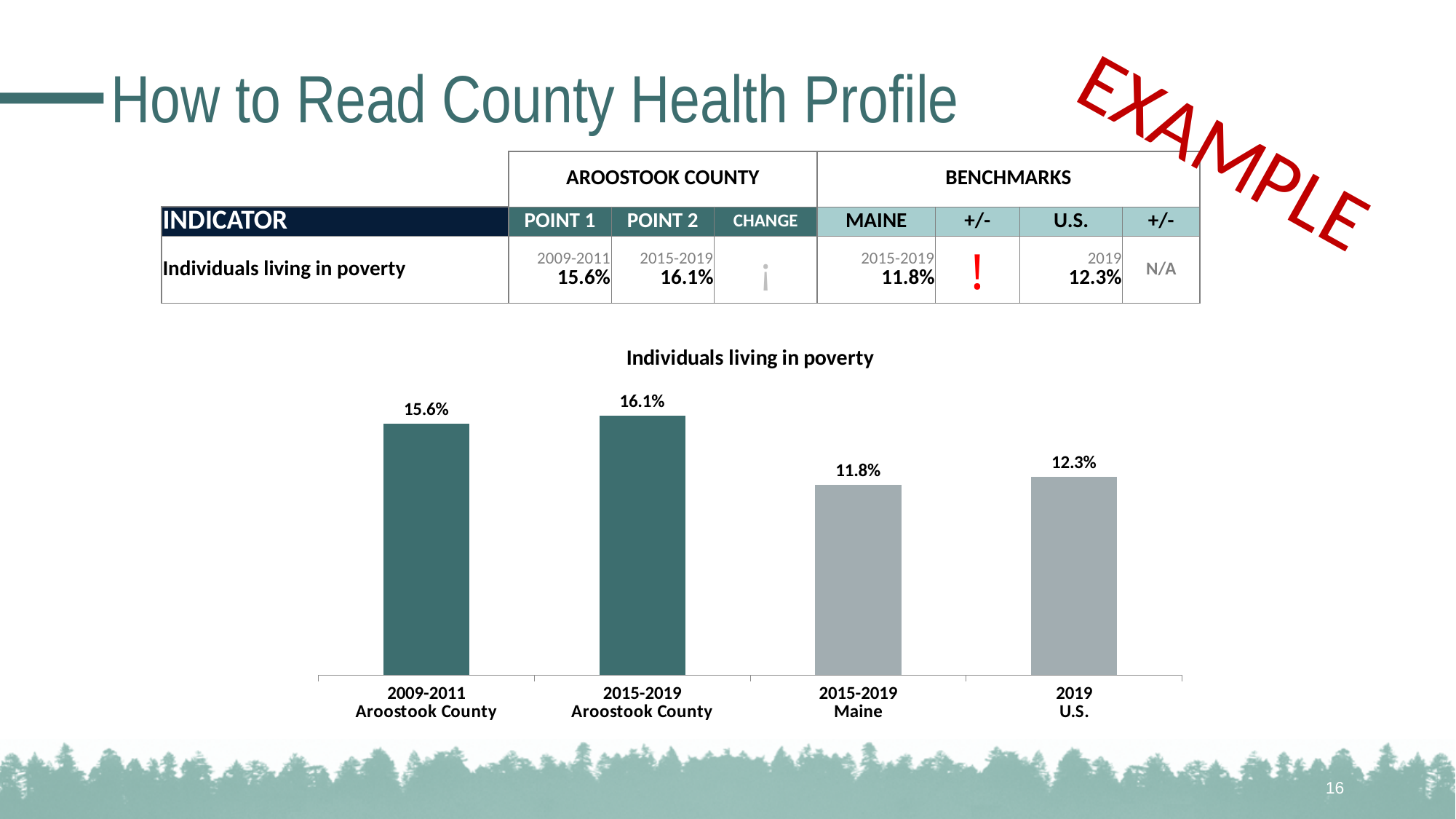
What is the value for 2015-2019 Aroostook County in the chart? 16.1% Which category has the highest value in the chart? 2015-2019 Aroostook County Which category has the lowest value in the chart? 2015-2019 Maine What is the difference between the 2015-2019 Aroostook County value and the 2015-2019 Maine value? 4.3% What is the value for 2019 U.S. in the chart? 12.3% What is the value for 2009-2011 Aroostook County in the chart? 15.6% What is the value for 2015-2019 Maine in the chart? 11.8% What type of chart is shown on the slide? Bar chart How many bars are shown in the chart? 4 What is the title of the chart? Individuals living in poverty What is the difference between the 2019 U.S. value and the 2015-2019 Maine value? 0.5% Which is larger, the value for 2009-2011 Aroostook County or the value for 2019 U.S.? 2009-2011 Aroostook County